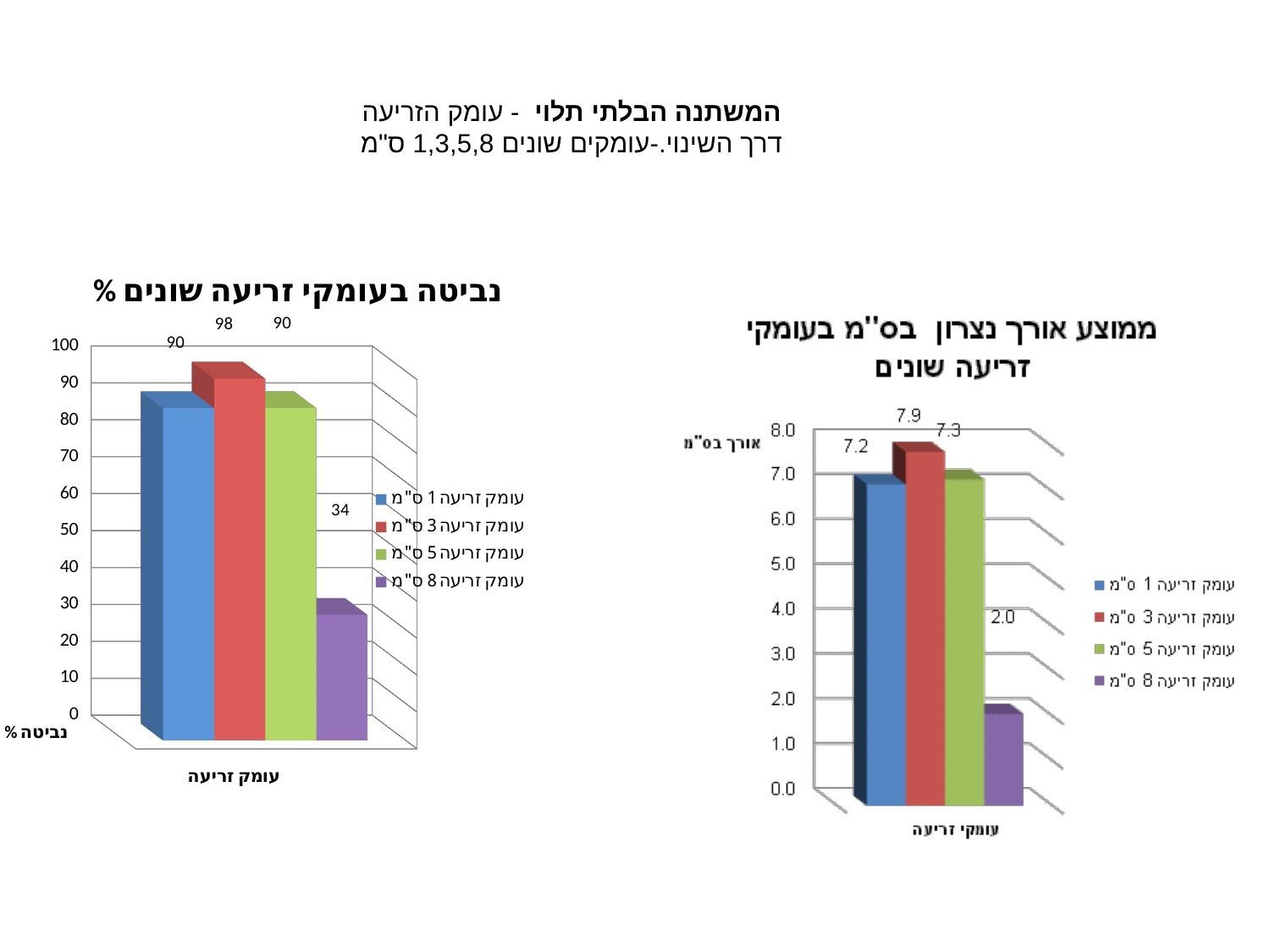
In the left chart (נביטה בעומקי זריעה שונים %), which series has the lowest value? עומק זריעה 8 ס"מ In the right chart (ממוצע אורך נצרון בס"מ בעומקי זריעה שונים), which series has the highest value? עומק זריעה 3 ס"מ In the right chart (ממוצע אורך נצרון בס"מ בעומקי זריעה שונים), which is larger: the value for sowing depth 1 cm or the value for sowing depth 8 cm? Sowing depth 1 cm In the right chart (ממוצע אורך נצרון בס"מ בעומקי זריעה שונים), what is the value for the series עומק זריעה 8 ס"מ (sowing depth 8 cm)? 2.0 What kind of chart is the right chart (ממוצע אורך נצרון בס"מ בעומקי זריעה שונים)? Bar chart In the left chart (נביטה בעומקי זריעה שונים %), what is the difference between the values for sowing depth 3 cm and sowing depth 8 cm? 64 In the left chart (נביטה בעומקי זריעה שונים %), what is the value for the series עומק זריעה 3 ס"מ (sowing depth 3 cm)? 98 In the right chart (ממוצע אורך נצרון בס"מ בעומקי זריעה שונים), what is the value for the series עומק זריעה 1 ס"מ (sowing depth 1 cm)? 7.2 In the left chart (נביטה בעומקי זריעה שונים %), what is the value for the series עומק זריעה 8 ס"מ (sowing depth 8 cm)? 34 In the left chart (נביטה בעומקי זריעה שונים %), which series has the highest value? עומק זריעה 3 ס"מ How many series does the legend of the left chart (נביטה בעומקי זריעה שונים %) list? 4 In the right chart (ממוצע אורך נצרון בס"מ בעומקי זריעה שונים), what is the difference between the values for sowing depth 3 cm and sowing depth 5 cm? 0.6